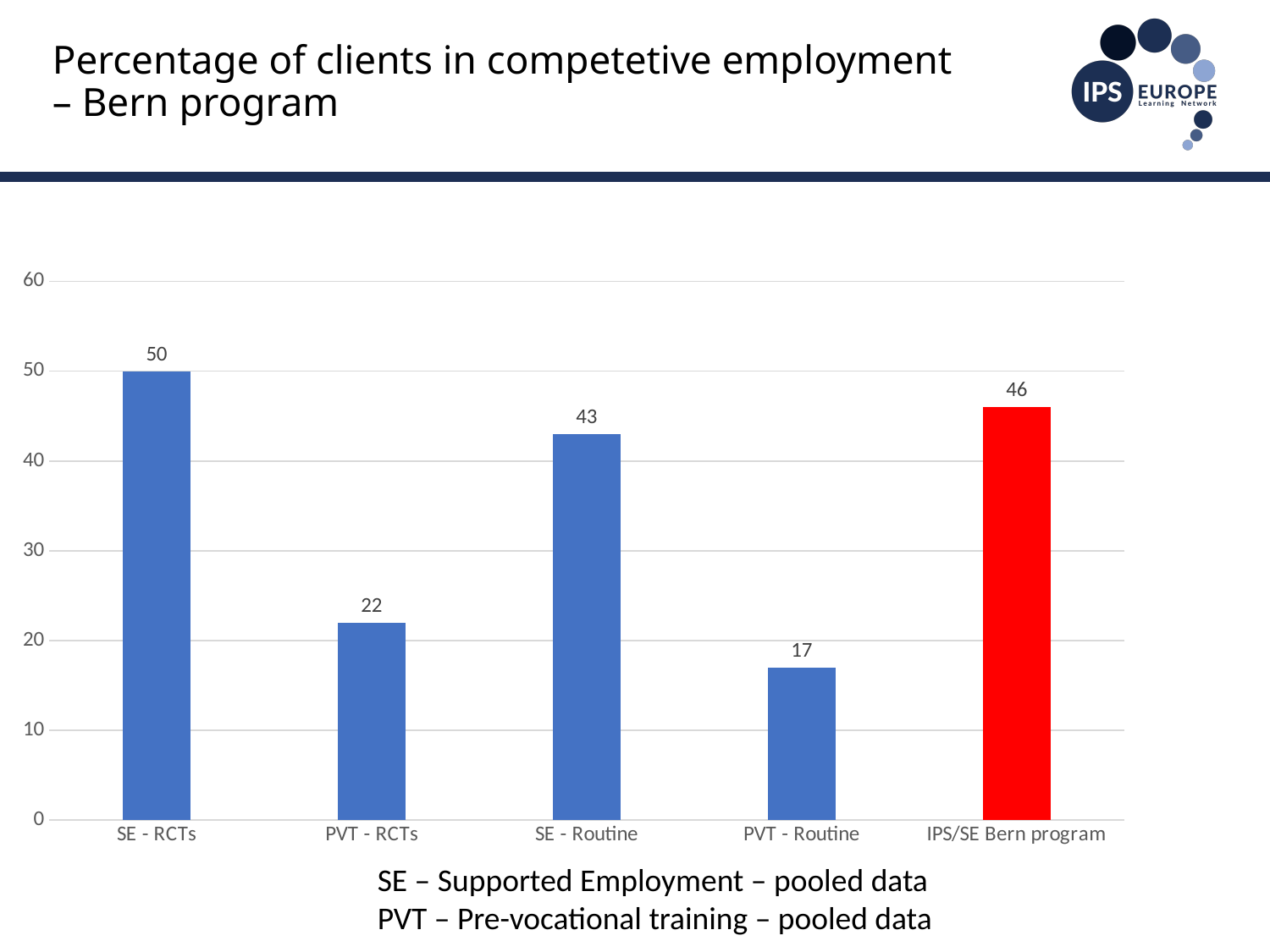
What is the difference between the values for SE - RCTs and PVT - RCTs? 28 Which is larger, the value for SE - Routine or the value for PVT - Routine? SE - Routine What is the value for IPS/SE Bern program? 46 Is the value for PVT - RCTs greater or less than 30? less Which category has the lowest value? PVT - Routine What is the value for SE - RCTs? 50 Which bar is coloured red? IPS/SE Bern program What is the value for PVT - Routine? 17 What kind of chart is shown on the slide? bar chart How many categories are shown on the x axis? 5 What is the difference between the values for IPS/SE Bern program and SE - Routine? 3 Which category has the highest value? SE - RCTs